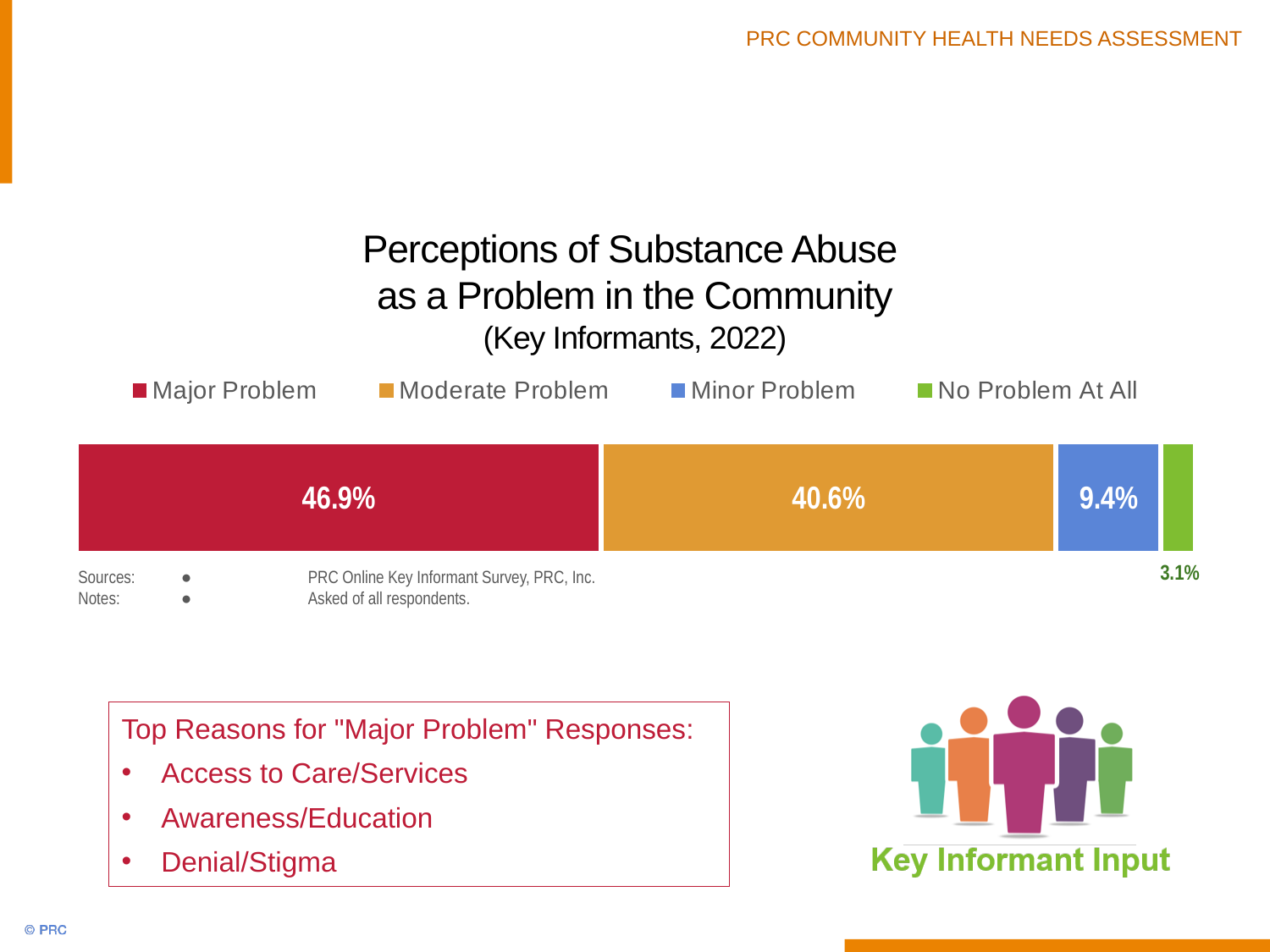
What colour represents the "Moderate Problem" segment in the chart? Orange Which is larger, the "Minor Problem" share or the "No Problem At All" share? Minor Problem What percentage of key informants rated substance abuse a "Minor Problem"? 9.4% What kind of chart is shown on the slide? Stacked bar chart Which response category has the smallest share in the chart? No Problem At All What is the difference in percentage points between the "Major Problem" and "Moderate Problem" shares? 6.3 What percentage of key informants said substance abuse is "No Problem At All"? 3.1% What percentage of key informants rated substance abuse a "Major Problem"? 46.9% What is the combined percentage of "Major Problem" and "Moderate Problem" responses? 87.5% What percentage of key informants rated substance abuse a "Moderate Problem"? 40.6% Which response category has the largest share in the chart? Major Problem How many response categories does the legend list? 4